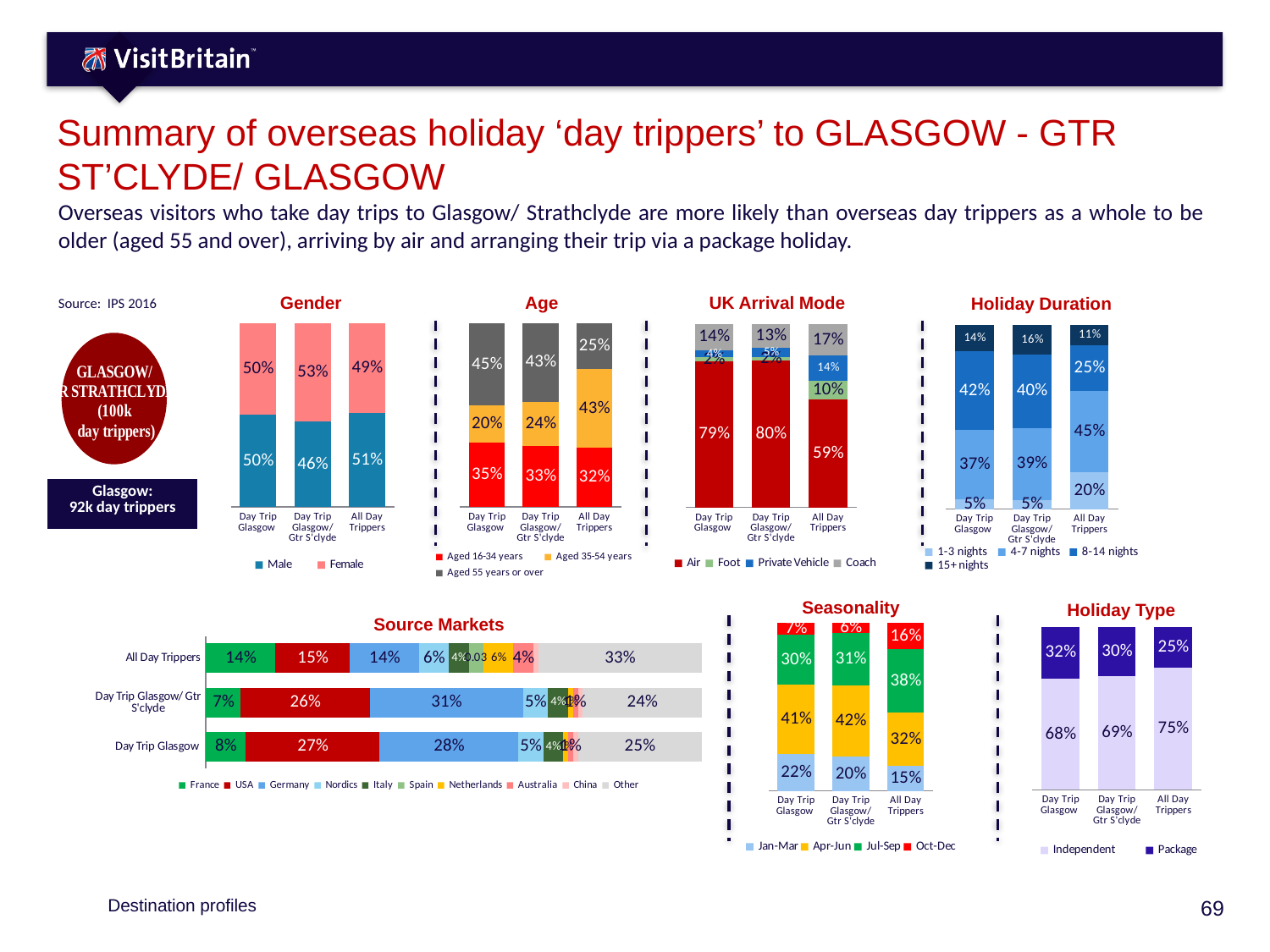
In the Source Markets chart, what percentage of Day Trip Glasgow visitors come from the USA? 27% In the Age chart, which group has the highest share of visitors Aged 35-54 years? All Day Trippers In the Age chart, what share of Day Trip Glasgow visitors are Aged 55 years or over? 45% In the Source Markets chart, is the Germany share larger for Day Trip Glasgow/Gtr S'clyde or for All Day Trippers? Day Trip Glasgow/Gtr S'clyde In the Holiday Duration chart, which group has the lowest share of 1-3 nights stays? Day Trip Glasgow and Day Trip Glasgow/Gtr S'clyde (both 5%) In the Seasonality chart, what percentage of Day Trip Glasgow/Gtr S'clyde visits occur in Apr-Jun? 42% In the Holiday Type chart, what percentage of All Day Trippers travel on a Package holiday? 25% In the Holiday Duration chart, what percentage of Day Trip Glasgow visitors stay 8-14 nights? 42% In the UK Arrival Mode chart, what is the difference between the Air share for Day Trip Glasgow/Gtr S'clyde and for All Day Trippers? 21 percentage points In the UK Arrival Mode chart, what percentage of All Day Trippers arrive by Air? 59% How many series does the legend of the Source Markets chart list? 10 In the Gender chart, what percentage of Day Trip Glasgow/Gtr S'clyde visitors are Female? 53%